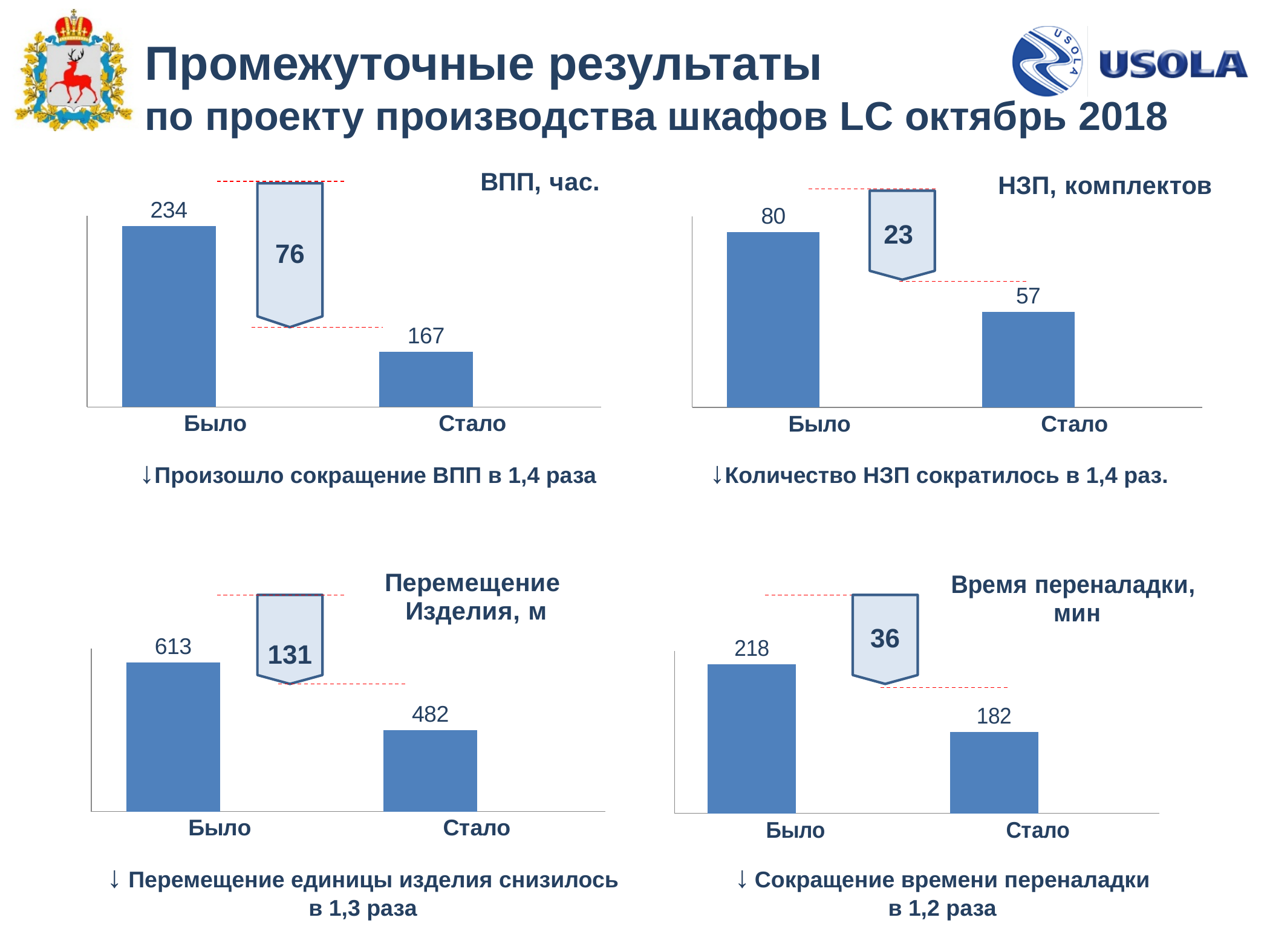
In the 'ВПП, час.' chart, what is the value for 'Стало'? 167 In the 'ВПП, час.' chart, do the values rise or fall from 'Было' to 'Стало'? fall How many categories are shown in the 'НЗП, комплектов' chart? 2 In the 'Перемещение Изделия, м' chart, what is the value for 'Было'? 613 In the 'Время переналадки, мин' chart, what is the value for 'Стало'? 182 In the 'НЗП, комплектов' chart, what is the value for 'Стало'? 57 In the 'ВПП, час.' chart, what is the value for 'Было'? 234 In the 'НЗП, комплектов' chart, what is the difference between 'Было' and 'Стало'? 23 In the 'Время переналадки, мин' chart, what is the difference between 'Было' and 'Стало'? 36 In the 'Время переналадки, мин' chart, which category has the higher value? Было What type of chart is the 'Перемещение Изделия, м' chart? bar chart In the 'Перемещение Изделия, м' chart, what is the difference between 'Было' and 'Стало'? 131